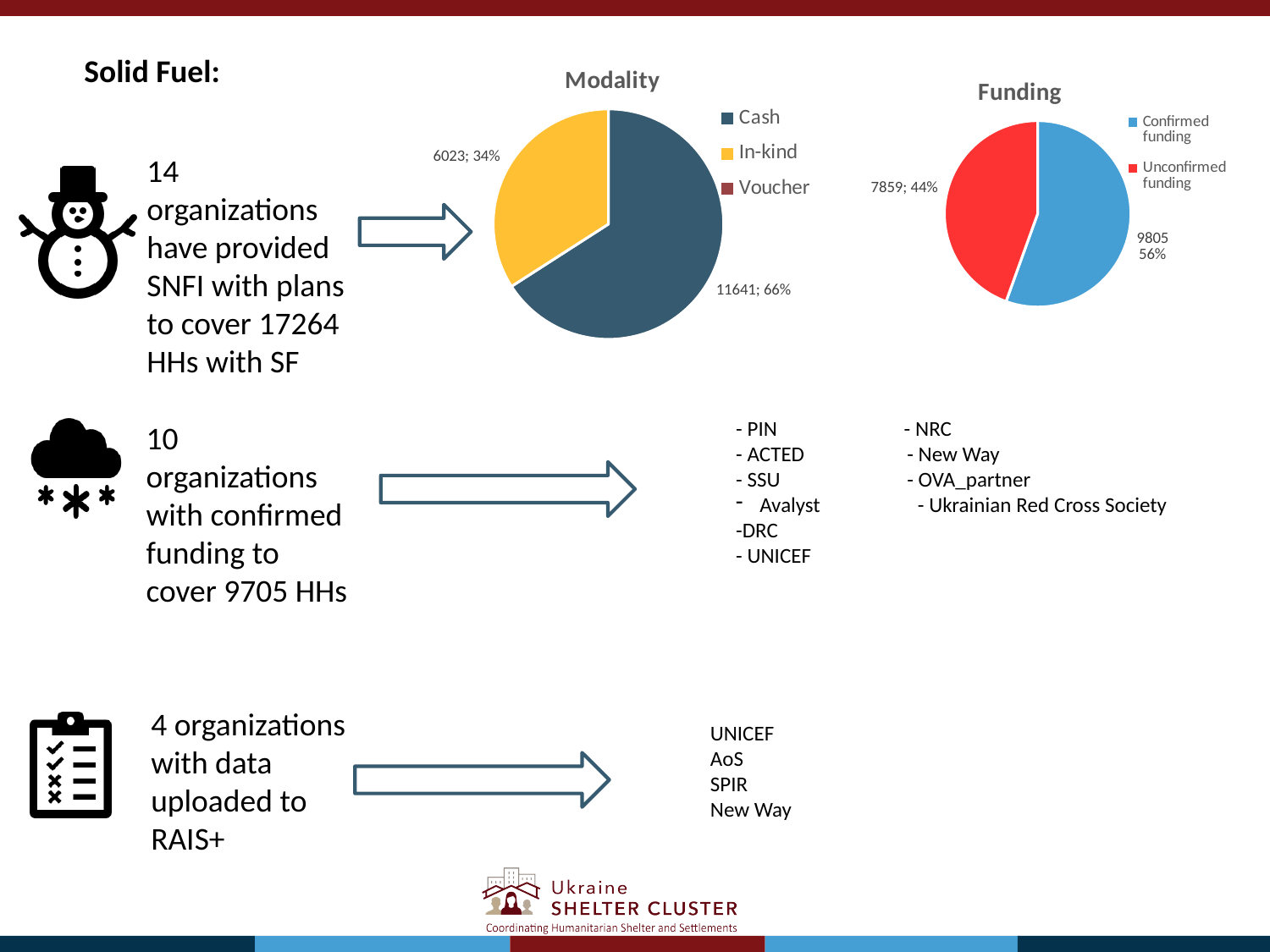
In the Modality chart, what value is shown for In-kind? 6023; 34% What kind of chart is the Funding chart? Pie chart In the Funding chart, what is the difference between Confirmed funding and Unconfirmed funding? 1946 In the Funding chart, what value is shown for Confirmed funding? 9805; 56% In the Modality chart, what is the difference between the Cash value and the In-kind value? 5618 In the Funding chart, what value is shown for Unconfirmed funding? 7859; 44% In the Funding chart, what colour is the Unconfirmed funding slice? Red How many entries does the legend of the Modality chart list? 3 In the Modality chart, what value is shown for Cash? 11641; 66% In the Modality chart, what share of the pie does In-kind represent? 34% In the Funding chart, which is larger, Confirmed funding or Unconfirmed funding? Confirmed funding In the Modality chart, which modality has the largest slice? Cash